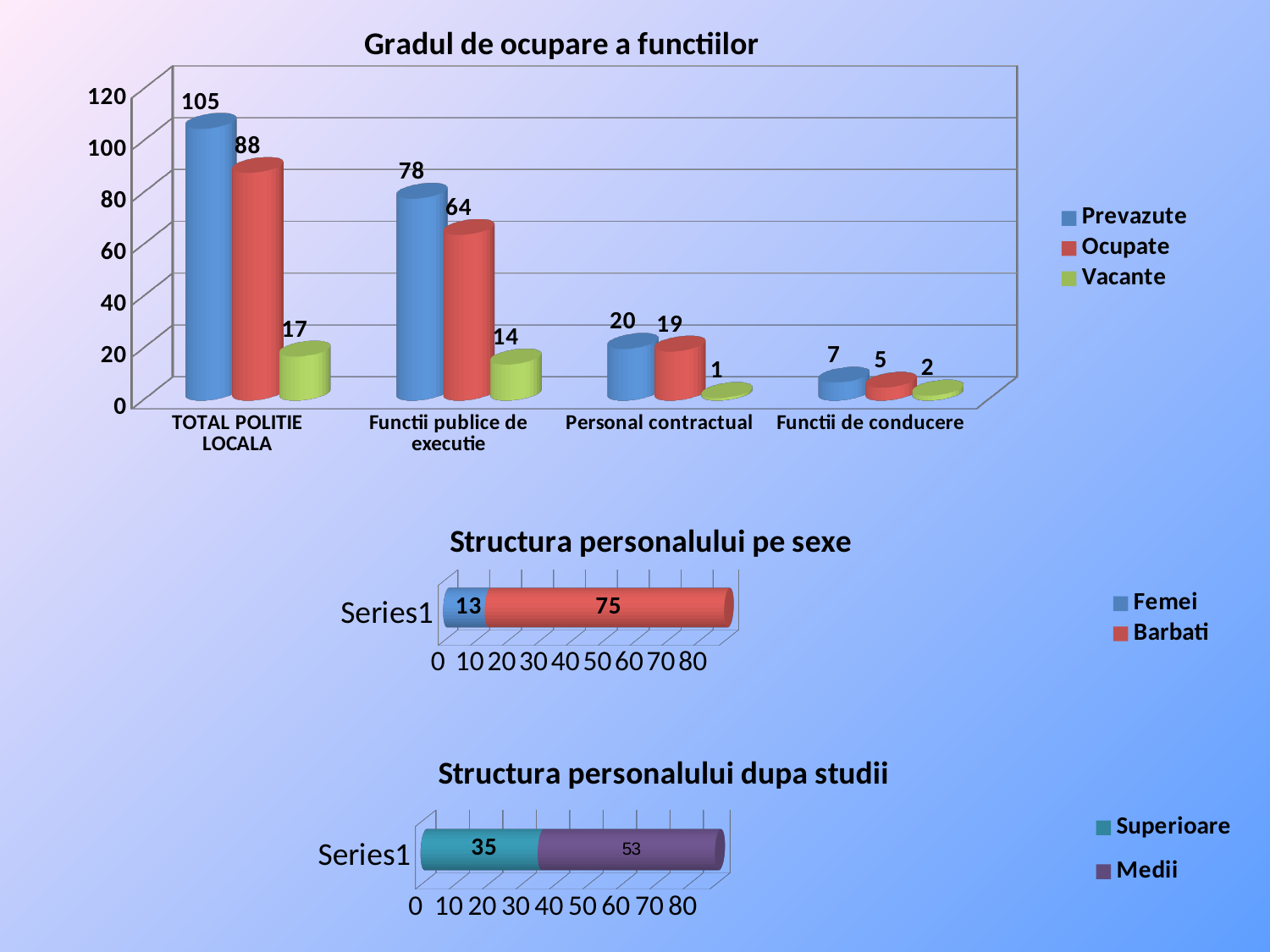
In the chart 'Structura personalului pe sexe', what is the value for Barbati? 75 In the chart 'Structura personalului pe sexe', what is the total of the stacked bar? 88 In the chart 'Gradul de ocupare a functiilor', what is the Vacante value for Personal contractual? 1 In the chart 'Gradul de ocupare a functiilor', how many categories are shown on the x axis? 4 In the chart 'Gradul de ocupare a functiilor', how many series does the legend list? 3 In the chart 'Gradul de ocupare a functiilor', which category has the lowest Prevazute value? Functii de conducere In the chart 'Gradul de ocupare a functiilor', what is the Ocupate value for Functii publice de executie? 64 In the chart 'Structura personalului dupa studii', what is the value for Superioare? 35 In the chart 'Structura personalului dupa studii', which is larger, Superioare or Medii? Medii What kind of chart is 'Structura personalului dupa studii'? Stacked bar chart In the chart 'Gradul de ocupare a functiilor', what is the Prevazute value for TOTAL POLITIE LOCALA? 105 In the chart 'Gradul de ocupare a functiilor', what is the difference between the Prevazute and Ocupate values for TOTAL POLITIE LOCALA? 17